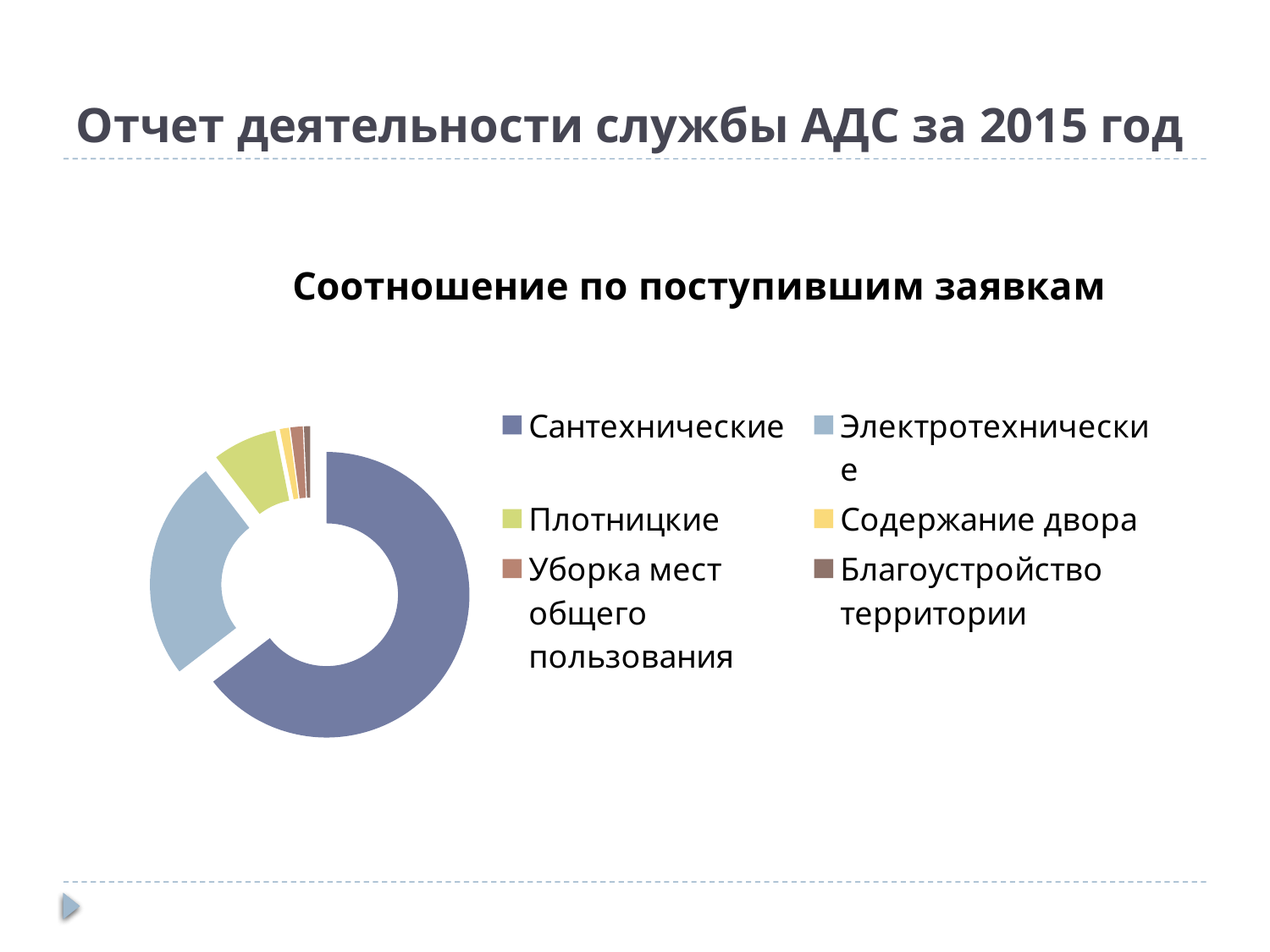
Which category has the largest share of the chart? Сантехнические What is the title of the chart? Соотношение по поступившим заявкам Which is larger: the share for Электротехнические or the share for Плотницкие? Электротехнические Does the Сантехнические slice take up more or less than half of the chart? more Which is larger: the share for Сантехнические or the share for Электротехнические? Сантехнические Which category has the second-largest share of the chart? Электротехнические Which is larger: the share for Плотницкие or the share for Содержание двора? Плотницкие What kind of chart is shown on the slide? Doughnut (pie) chart How many categories does the chart's legend list? 6 Which category is shown in green in the chart? Плотницкие